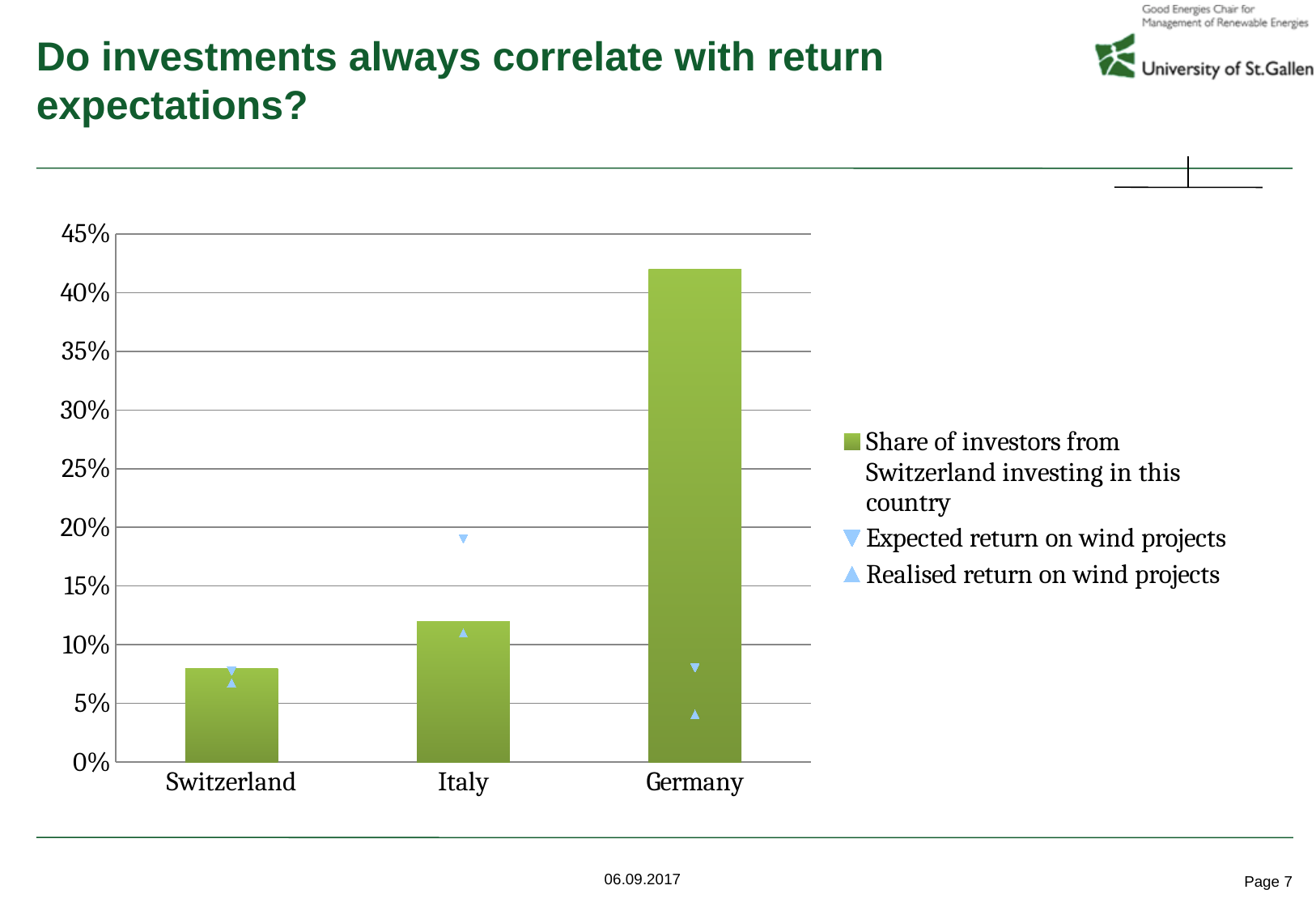
Which country has the lowest realised return on wind projects? Germany Is the share of investors from Switzerland investing in Switzerland greater or less than 10%? less Which country has the highest expected return on wind projects? Italy Is the share of investors from Switzerland investing in Italy greater or less than 10%? greater How many series does the chart's legend list? 3 Which series in the legend is shown with a downward-pointing triangle marker? Expected return on wind projects Which country has the lowest share of investors from Switzerland investing in it? Switzerland How many countries are shown on the x axis of the chart? 3 Which country has the highest share of investors from Switzerland investing in it? Germany Is the realised return on wind projects in Germany greater or less than 5%? less What kind of chart is shown on the slide? bar chart